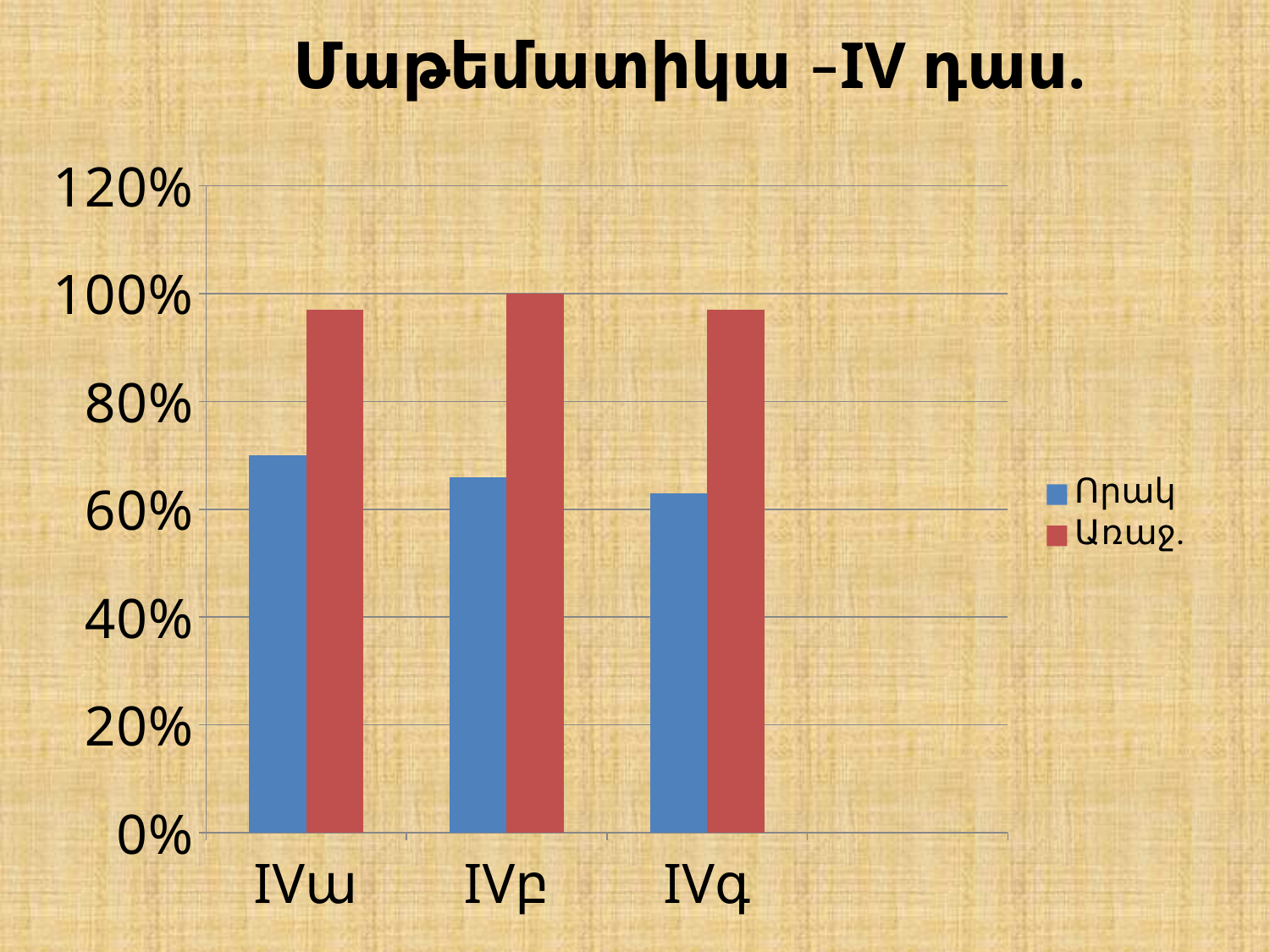
Do the Որակ values rise or fall from IVա to IVգ? fall Is the value of Որակ for IVա greater or less than 60%? greater Which series is shown in red? Առաջ. Is the value of Որակ for IVգ greater or less than 80%? less How many series does the legend list? 2 What is the title of the chart? Մաթեմատիկա -IV դաս. Which category has the lowest Որակ value? IVգ Is the value of Առաջ. for IVա greater or less than 80%? greater How many categories are shown on the x axis? 3 For IVգ, which is larger: Որակ or Առաջ.? Առաջ. What is the value of Առաջ. for IVբ? 100% What kind of chart is shown on the slide? bar chart